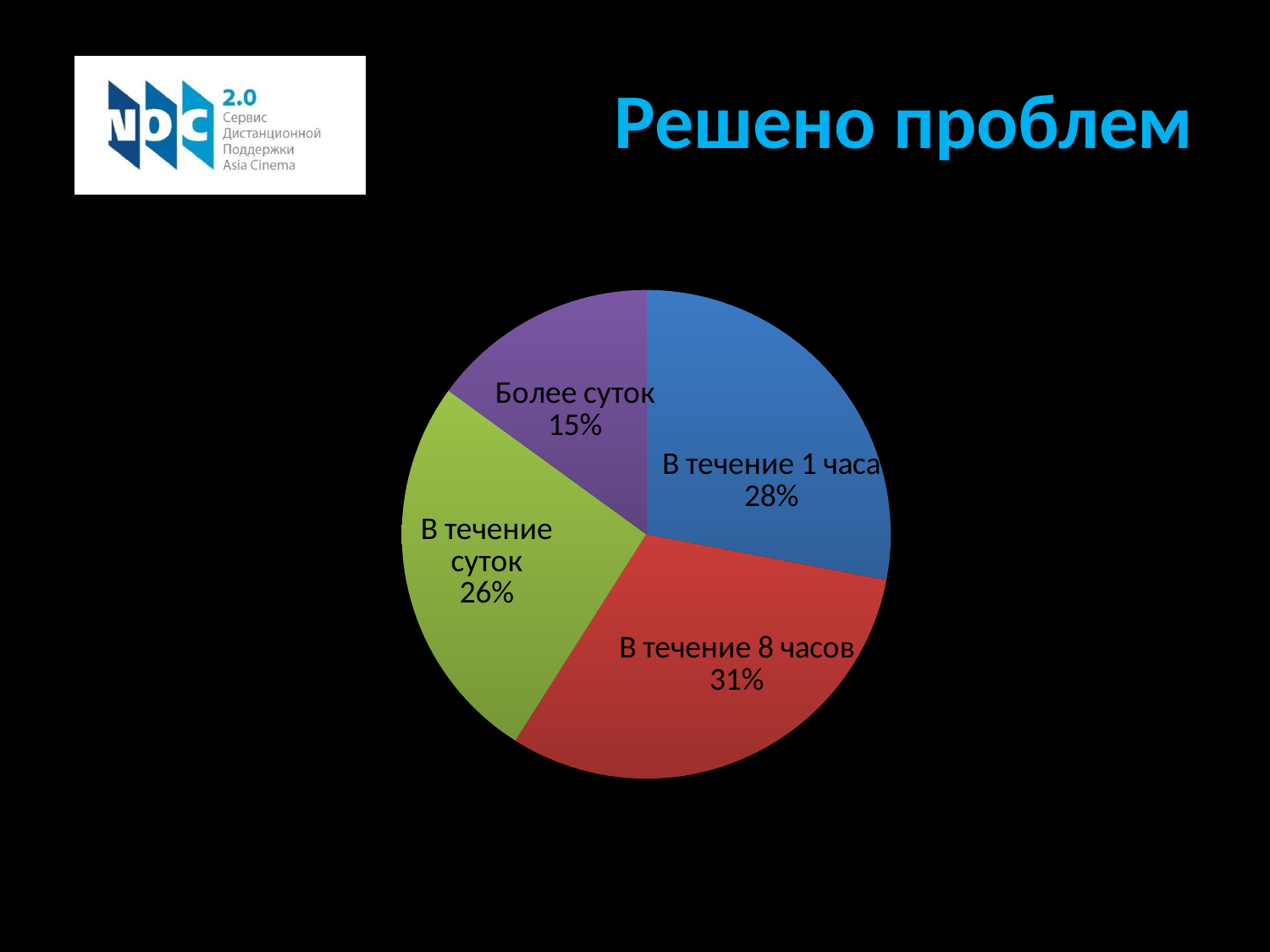
What kind of chart is shown on the slide? pie chart Which slice of the pie is the smallest? Более суток What share of the pie does "В течение 8 часов" have? 31% How many slices does the pie chart have? 4 What is the difference in percentage points between "В течение 1 часа" and "В течение суток"? 2 What share of the pie does "В течение суток" have? 26% What share of the pie does "В течение 1 часа" have? 28% Which slice of the pie is the largest? В течение 8 часов What is the difference in percentage points between "В течение 8 часов" and "Более суток"? 16 Which is larger, the share for "В течение 1 часа" or the share for "Более суток"? В течение 1 часа What is the title shown on the slide above the chart? Решено проблем